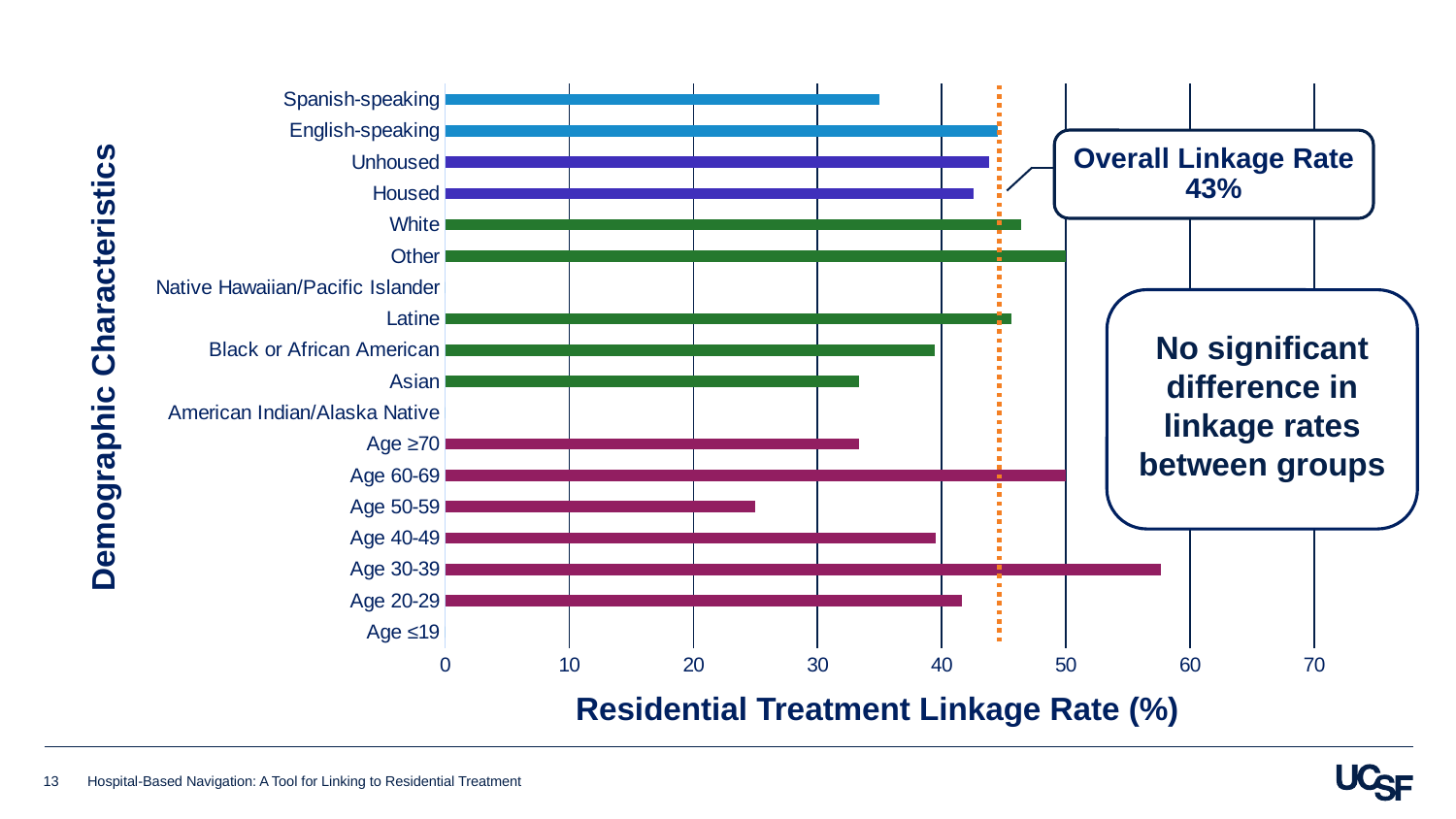
What is the title of the x axis of the chart? Residential Treatment Linkage Rate (%) Which has a higher linkage rate, Spanish-speaking or English-speaking? English-speaking Is the value for Age 30-39 greater or less than 50? greater What kind of chart is shown on the slide? bar chart What overall linkage rate is shown in the callout box on the chart? 43% Among the categories with a plotted bar, which has the lowest residential treatment linkage rate? Age 50-59 Is the value for Spanish-speaking greater or less than 40? less How many demographic categories are listed on the y axis of the chart? 18 Is the value for Age 50-59 greater or less than 30? less Which category has the highest residential treatment linkage rate? Age 30-39 Which has a higher linkage rate, Other or Asian? Other